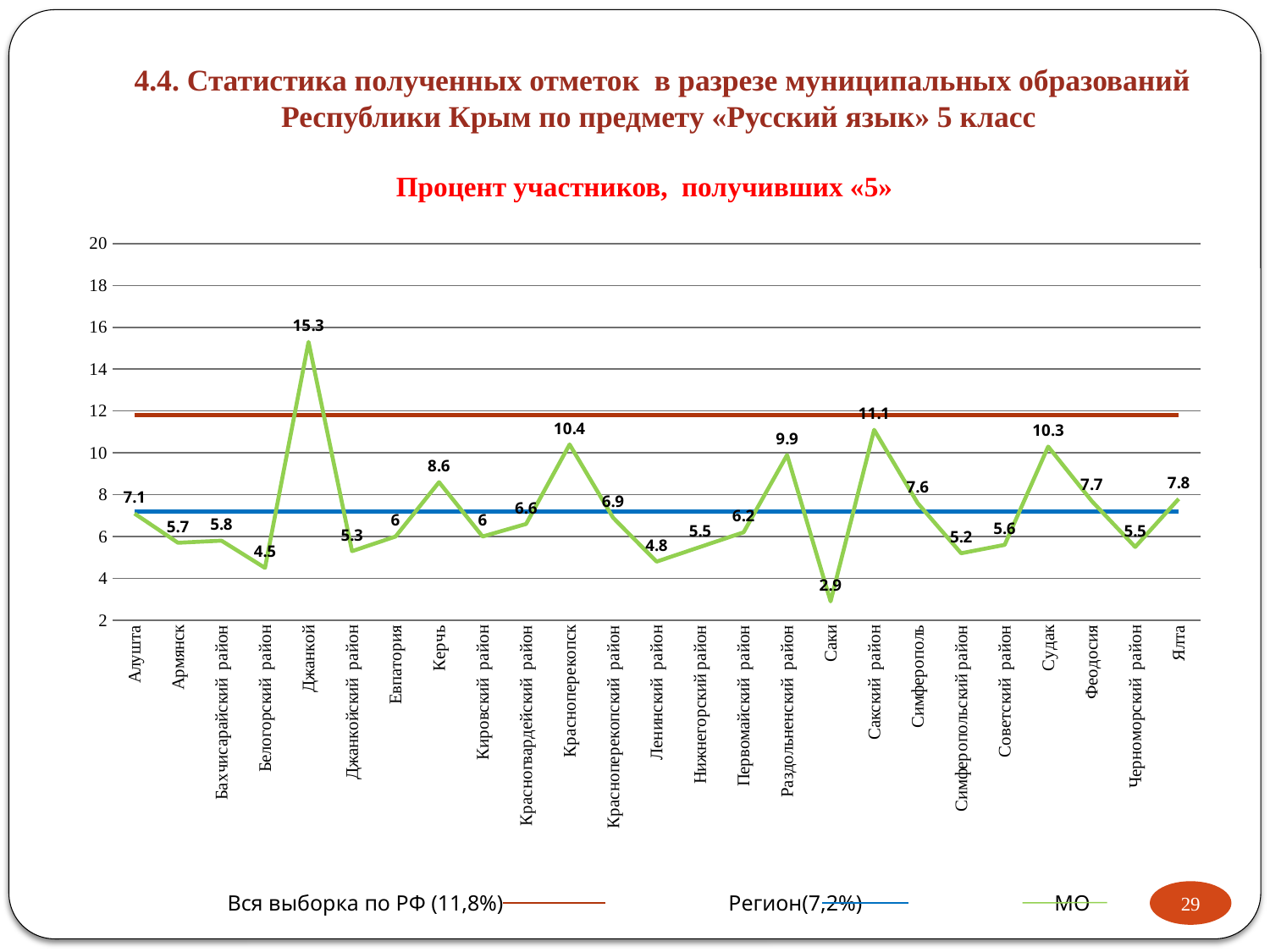
What value does the legend give for the series 'Вся выборка по РФ'? 11,8% Which has a higher МО value, Красноперекопск or Сакский район? Сакский район What type of chart is shown on the slide? line chart What is the value for Джанкой on the МО line? 15.3 What is the value for Судак on the МО line? 10.3 What is the value for Саки on the МО line? 2.9 Which municipality has the highest value on the МО line? Джанкой What is the difference between the МО values for Джанкой and Саки? 12.4 Which municipality has the lowest value on the МО line? Саки How many series does the legend list? 3 What is the title of the chart? Процент участников, получивших «5» How many municipalities are plotted along the x axis? 25